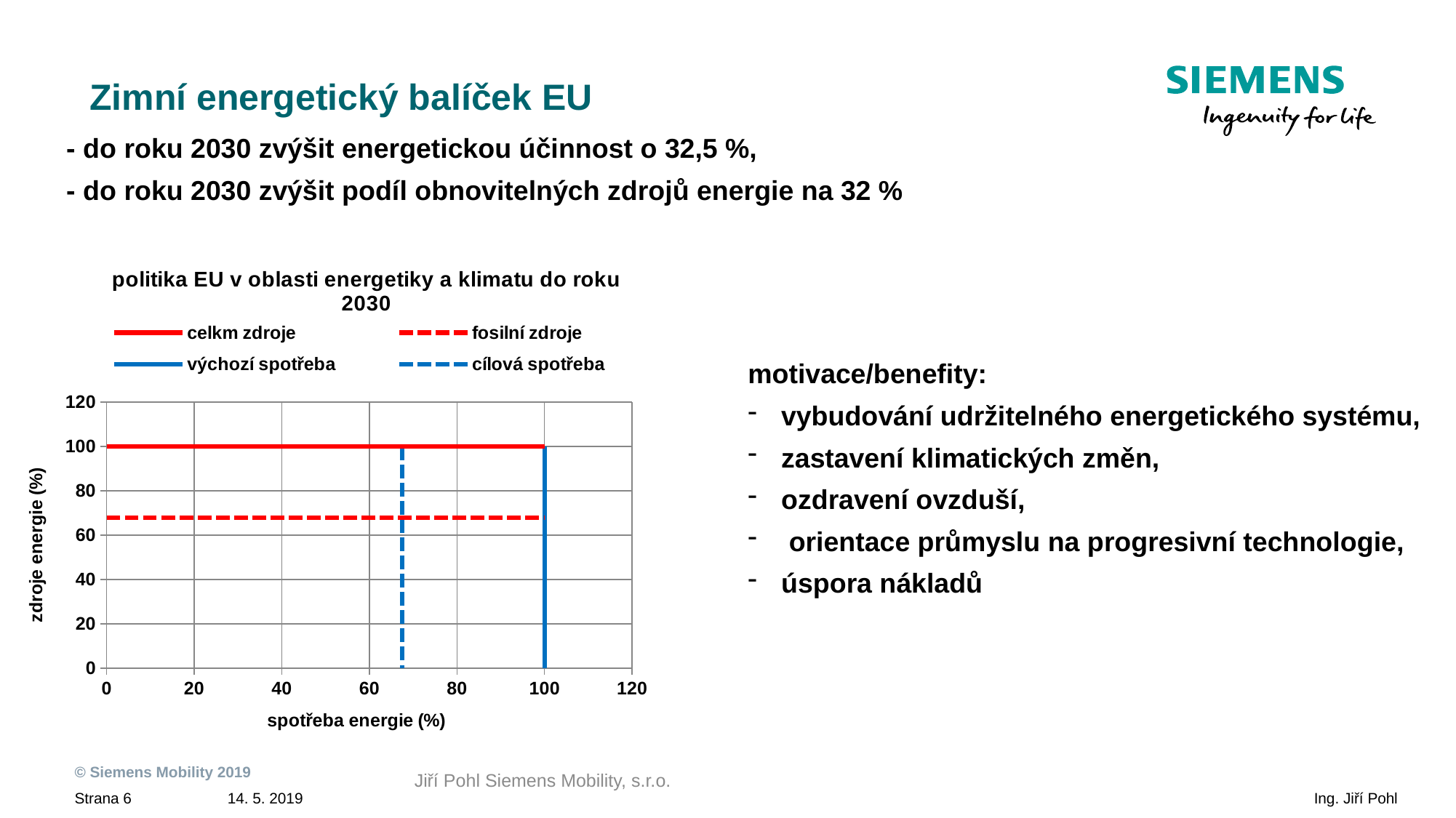
Is the x-axis position of the dashed blue 'cílová spotřeba' line greater or less than 60? greater Is the y-axis value of the dashed red 'fosilní zdroje' line greater or less than 80? less At what value on the y axis does the solid red 'celkm zdroje' line run? 100 Which horizontal line is higher on the y axis, 'celkm zdroje' or 'fosilní zdroje'? celkm zdroje How many series does the chart legend list? 4 What type of chart is shown on the slide? line chart Is the x-axis position of the dashed blue 'cílová spotřeba' line greater or less than 80? less What is the title of the chart? politika EU v oblasti energetiky a klimatu do roku 2030 At what value on the x axis does the solid blue 'výchozí spotřeba' line stand? 100 What is the label of the chart's y axis? zdroje energie (%) Which vertical line is further right on the x axis, 'výchozí spotřeba' or 'cílová spotřeba'? výchozí spotřeba